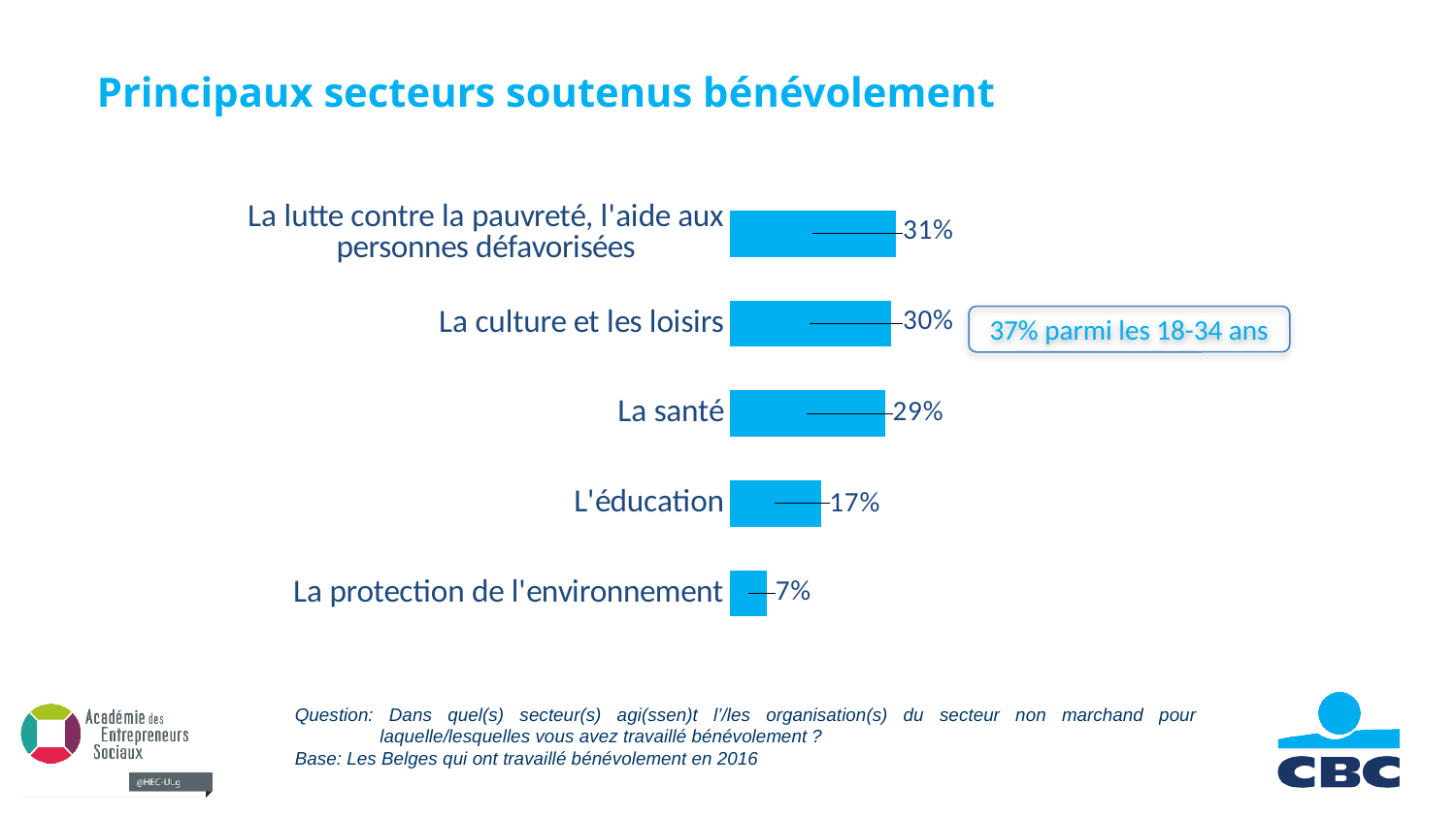
What is the value for "La santé"? 29% According to the callout next to "La culture et les loisirs", what is the value among 18-34 year olds? 37% Which is larger, the value for "L'éducation" or the value for "La protection de l'environnement"? L'éducation Which category has the lowest value? La protection de l'environnement What is the value for "L'éducation"? 17% What kind of chart is shown on the slide? Bar chart How many categories are shown in the chart? 5 Which category has the highest value? La lutte contre la pauvreté, l'aide aux personnes défavorisées What is the value for "La protection de l'environnement"? 7% What is the difference between the values for "La lutte contre la pauvreté, l'aide aux personnes défavorisées" and "La protection de l'environnement"? 24% What is the value for "La culture et les loisirs"? 30% What is the difference between the values for "La santé" and "L'éducation"? 12%